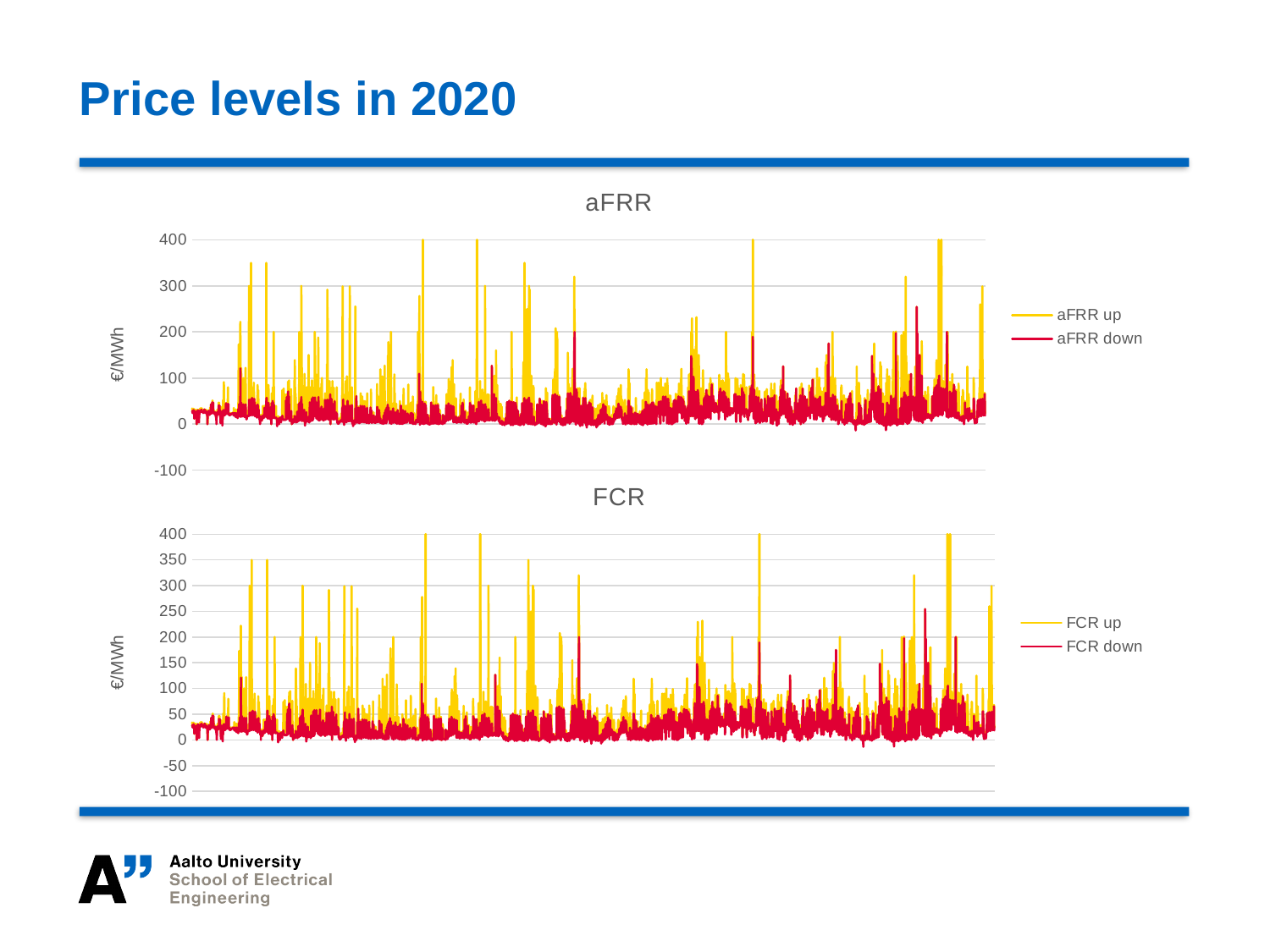
What kind of chart is the aFRR chart? line chart In the aFRR chart, is the highest peak of the aFRR up series greater or less than 300? greater In the FCR chart, which series reaches higher peaks, FCR up or FCR down? FCR up What kind of chart is the FCR chart? line chart How many series does the legend of the FCR chart list? 2 In the FCR chart, is the highest peak of the FCR down series greater or less than 300? less In the aFRR chart, which colour is used for the aFRR down series? red In the aFRR chart, which series reaches higher peaks, aFRR up or aFRR down? aFRR up In the FCR chart, is the highest peak of the FCR up series greater or less than 350? greater What is the y-axis label of the FCR chart? €/MWh How many series does the legend of the aFRR chart list? 2